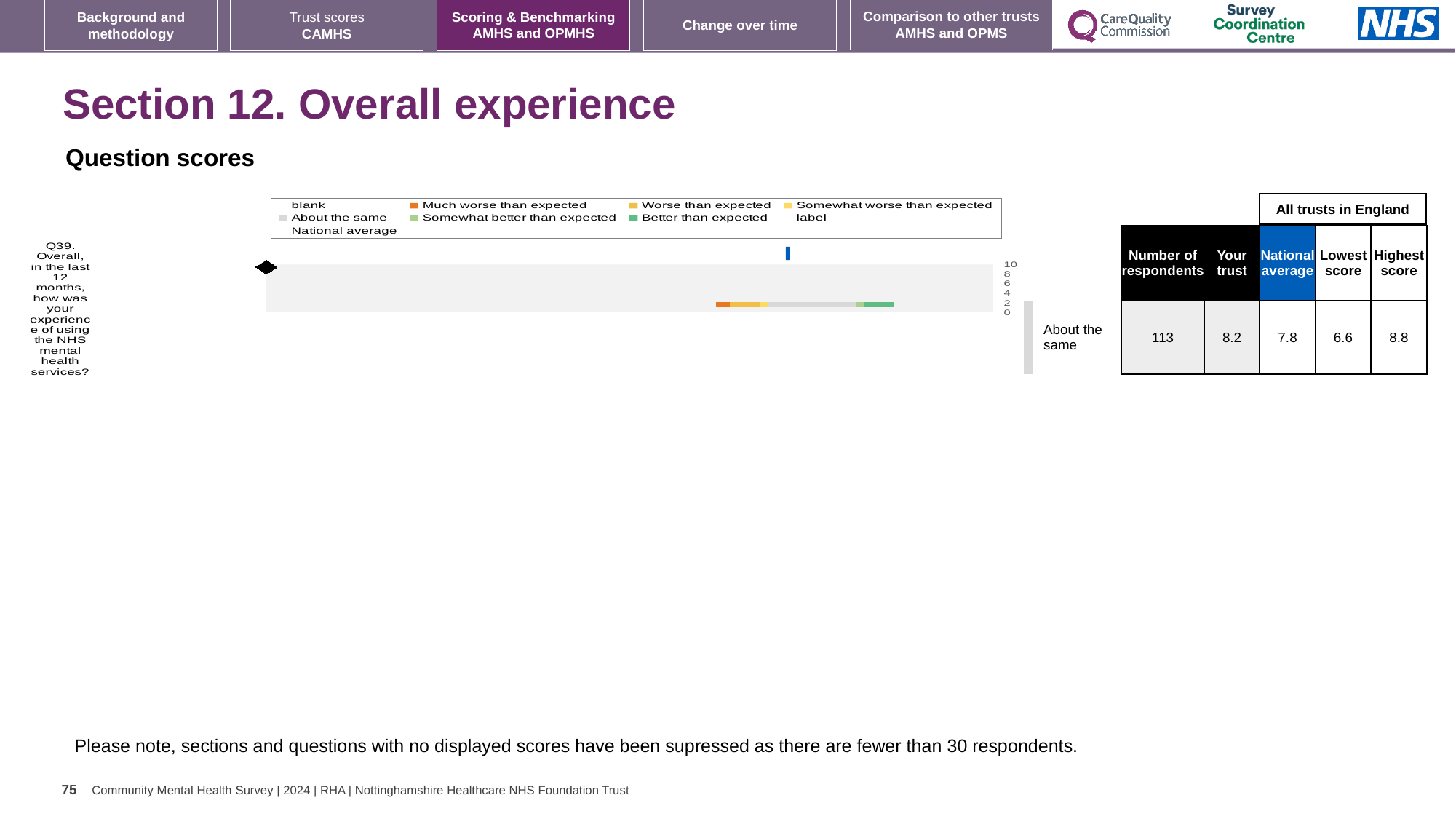
What is the difference between the 'Your trust' score and the national average for Q39? 0.4 What is the 'Your trust' score for Q39 (Overall, in the last 12 months, how was your experience of using the NHS mental health services?)? 8.2 What is the highest score among all trusts in England for Q39? 8.8 What benchmark category is shown next to the Q39 bar? About the same For Q39, which is higher: the 'Your trust' score or the national average? Your trust How many respondents answered Q39? 113 What is the national average score for Q39? 7.8 What kind of chart is used to show the Q39 question score? Bar chart What is the lowest score among all trusts in England for Q39? 6.6 According to the legend, what does the blue marker on the chart represent? National average How many questions are plotted in the Question scores chart? 1 What is the difference between the highest and lowest scores for Q39 across all trusts in England? 2.2